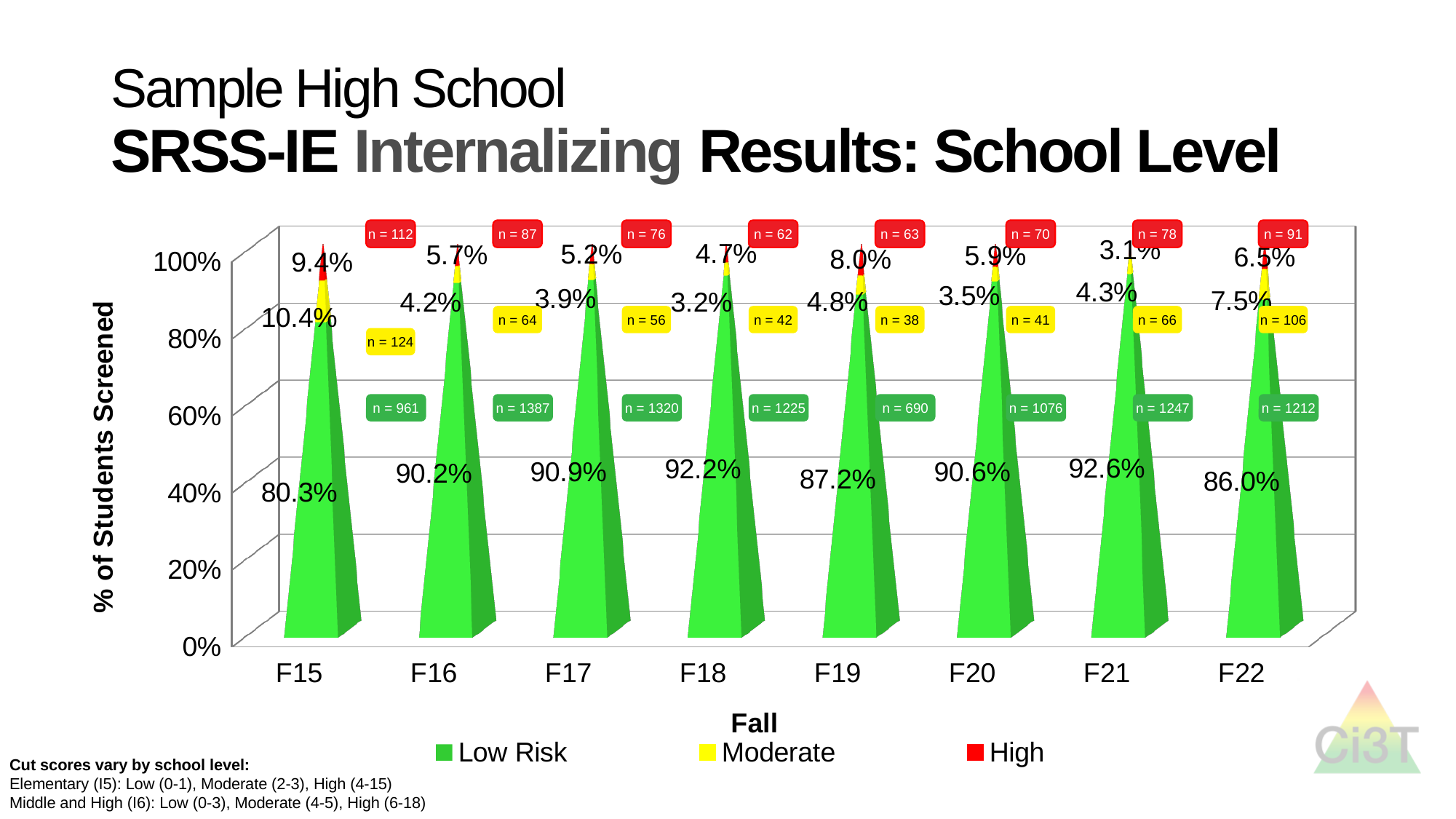
Is the High percentage larger for F19 or F21? F19 Which fall has the highest Moderate percentage? F15 What is the Moderate percentage for F22? 7.5% How many fall time points are shown on the x axis? 8 What is the Low Risk percentage for F15? 80.3% What is the n value shown for the Low Risk group in F16? n = 1387 How many series does the legend list? 3 What is the High percentage for F19? 8.0% What is the title of the x axis? Fall Which fall has the highest Low Risk percentage? F21 What is the difference between the Low Risk percentages for F18 and F15? 11.9% Which fall has the lowest Low Risk percentage? F15